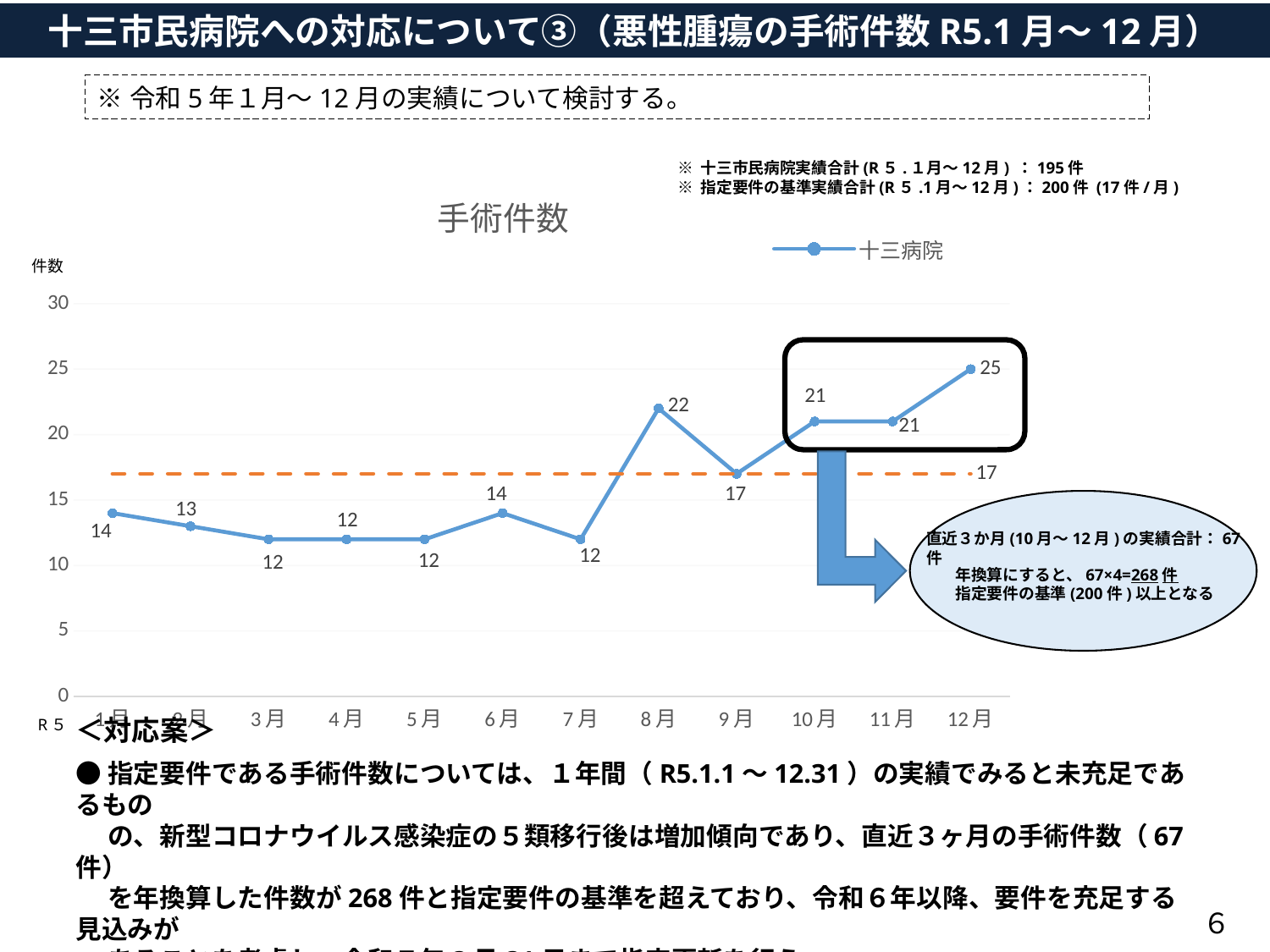
Which month has the highest value in the 手術件数 chart? 12月 What type of chart is shown on the slide? line chart Which is larger, the value for 8月 or the value for 9月? 8月 What is the difference between the values for 12月 and 11月? 4 How many series does the chart legend list? 1 How many months are plotted on the x axis of the chart? 12 What is the value for 8月 in the 手術件数 chart? 22 What is the value for 9月 in the 手術件数 chart? 17 What is the title of the chart? 手術件数 Is the value for 10月 greater or less than 20? greater What is the value for 1月 in the 手術件数 chart? 14 What is the value for 12月 in the 手術件数 chart? 25